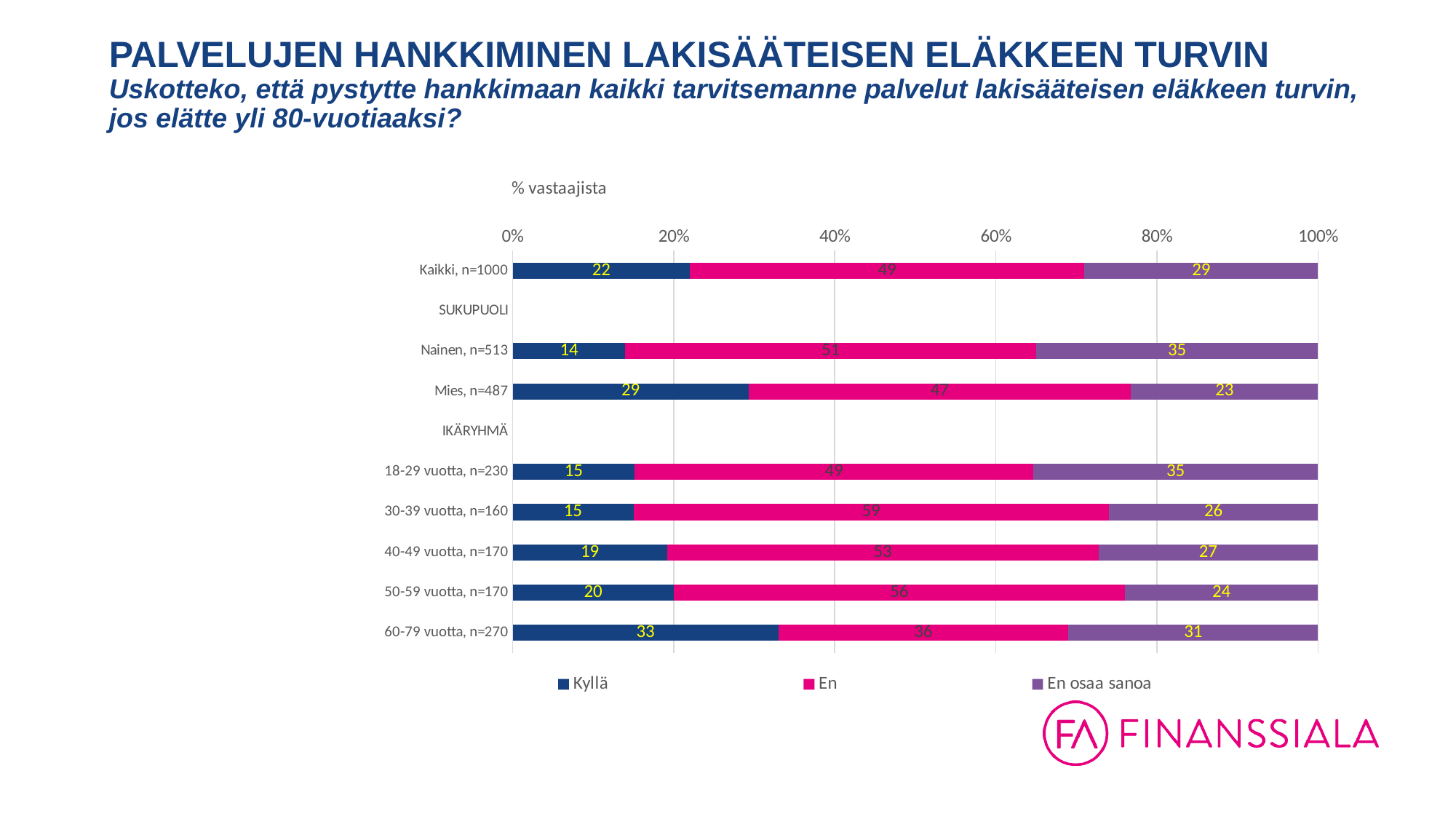
What is the En value for Nainen, n=513? 51 How many groups (bars) are plotted in the chart? 8 What is the name of the series shown in pink? En What kind of chart is shown on the slide? Stacked bar chart Which is larger, the En osaa sanoa value for 18-29 vuotta, n=230 or for 50-59 vuotta, n=170? 18-29 vuotta, n=230 Which group has the lowest Kyllä value? Nainen, n=513 What is the En osaa sanoa value for Mies, n=487? 23 Which group has the highest Kyllä value? 60-79 vuotta, n=270 How many series does the legend list? 3 What is the difference between the Kyllä values for Mies, n=487 and Nainen, n=513? 15 Which group has the highest En value? 30-39 vuotta, n=160 What is the Kyllä value for Kaikki, n=1000? 22